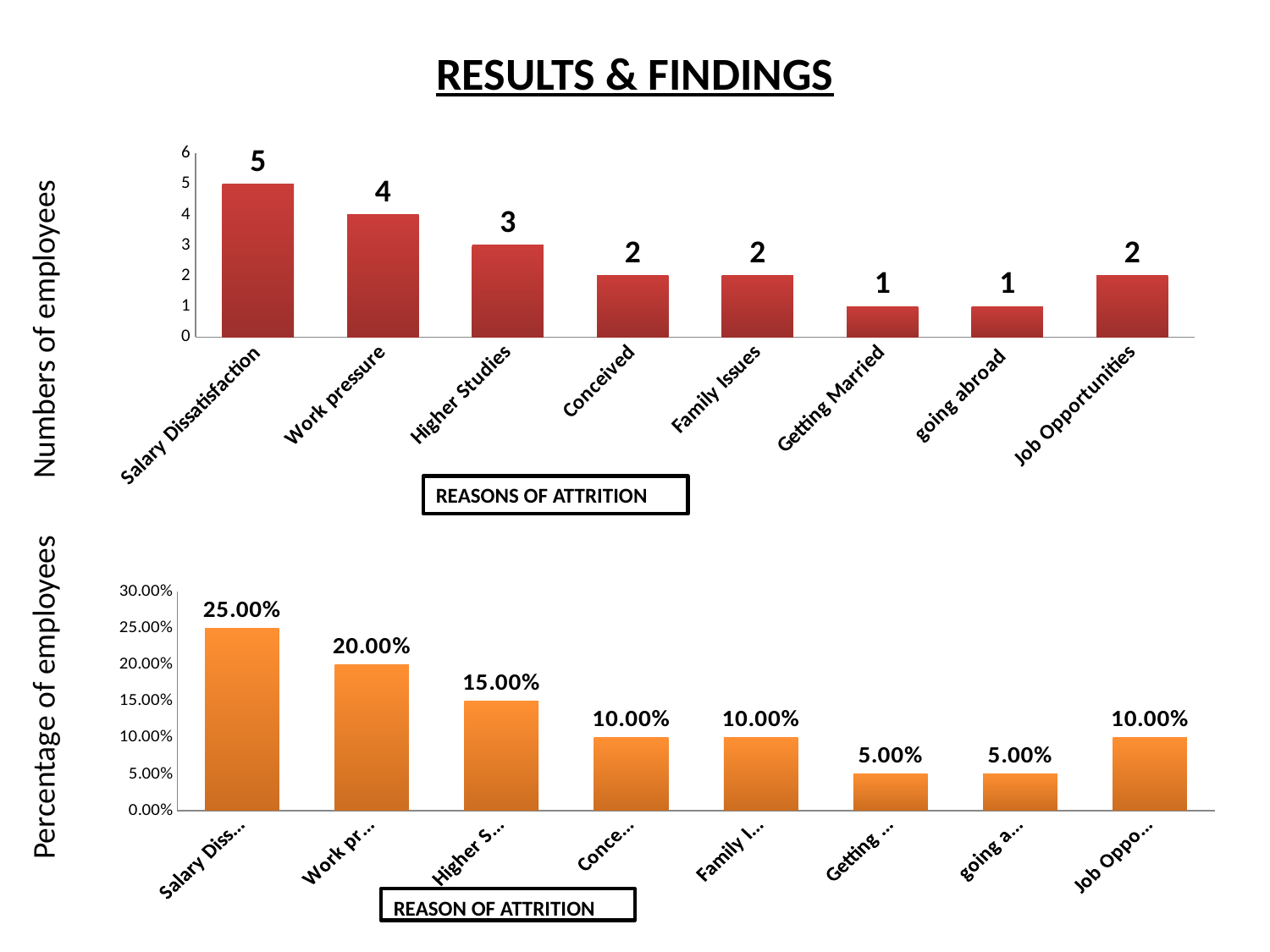
In the top chart (Numbers of employees), what is the value for Higher Studies? 3 What kind of chart is the top chart (Numbers of employees)? Bar chart In the bottom chart (Percentage of employees), what is the value for the third bar (Higher Studies)? 15.00% In the bottom chart (Percentage of employees), what is the difference between the Work pressure bar and the Family Issues bar? 10.00% What is the x-axis title of the top chart? REASONS OF ATTRITION In the top chart (Numbers of employees), which reason has the highest number of employees? Salary Dissatisfaction In the top chart (Numbers of employees), how many reasons of attrition are shown? 8 In the bottom chart (Percentage of employees), what is the value for the first bar (Salary Dissatisfaction)? 25.00% In the top chart (Numbers of employees), what is the value for Salary Dissatisfaction? 5 In the top chart (Numbers of employees), which is larger, Conceived or going abroad? Conceived In the top chart (Numbers of employees), what is the difference between Work pressure and Getting Married? 3 In the bottom chart (Percentage of employees), what is the lowest percentage value shown? 5.00%